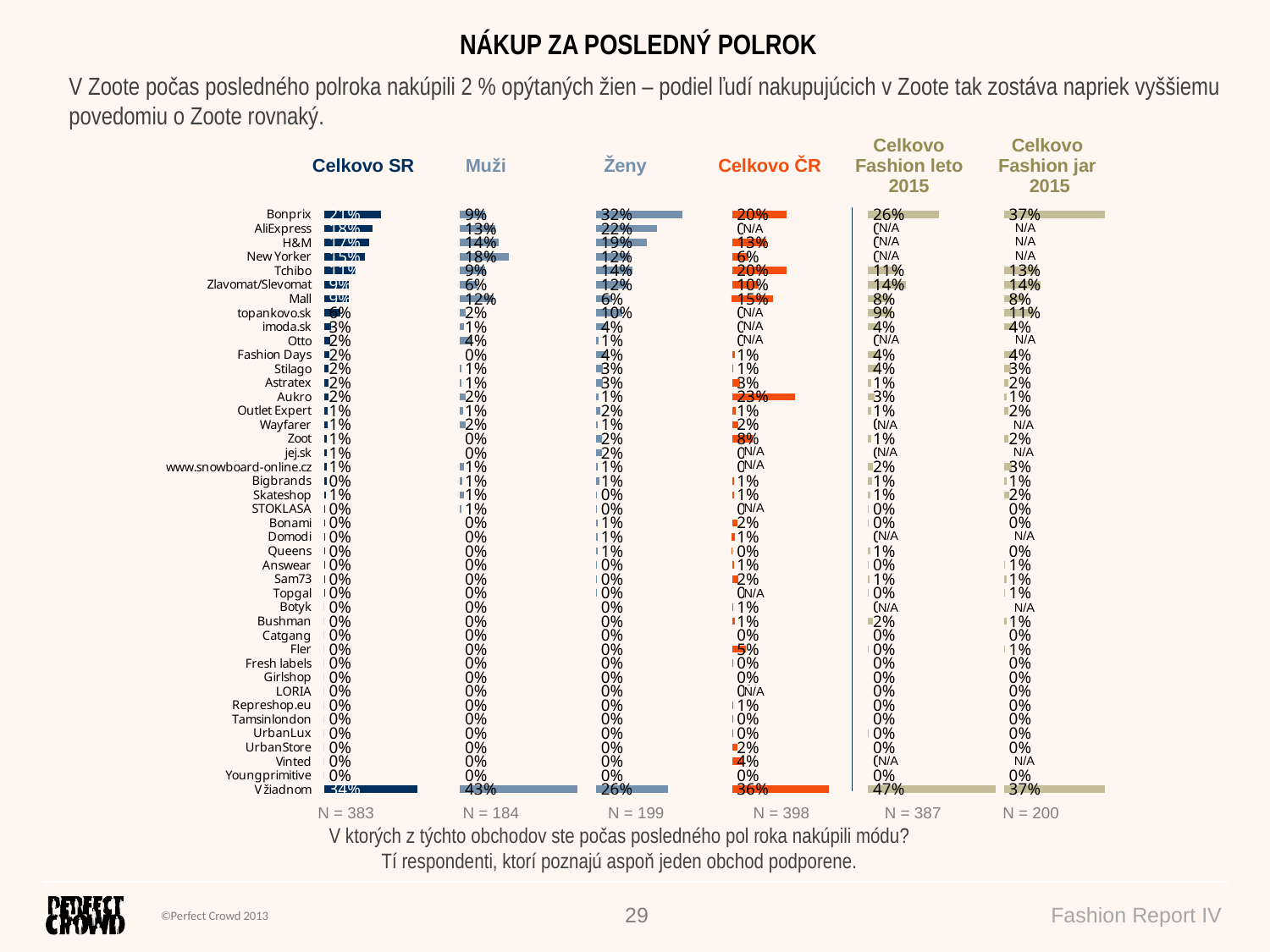
Which shop (excluding 'V žiadnom') has the highest value in the Muži column? New Yorker How many columns (series) does the chart show? 6 Which category has the highest value in the Ženy column? Bonprix Which is larger for Mall: the Muži value or the Ženy value? Muži What is the value for 'V žiadnom' in the Celkovo Fashion leto 2015 column? 47% What is the value for Aukro in the Celkovo ČR column? 23% What is the sample size (N) for the Celkovo ČR column? 398 What is the value for Bonprix in the Celkovo Fashion jar 2015 column? 37% What percentage of women (Ženy) bought at Bonprix in the last half year? 32% What type of chart is shown on the slide? Bar chart What is the value for New Yorker in the Muži column? 18% What is the difference between the Ženy and Muži values for Bonprix? 23 percentage points